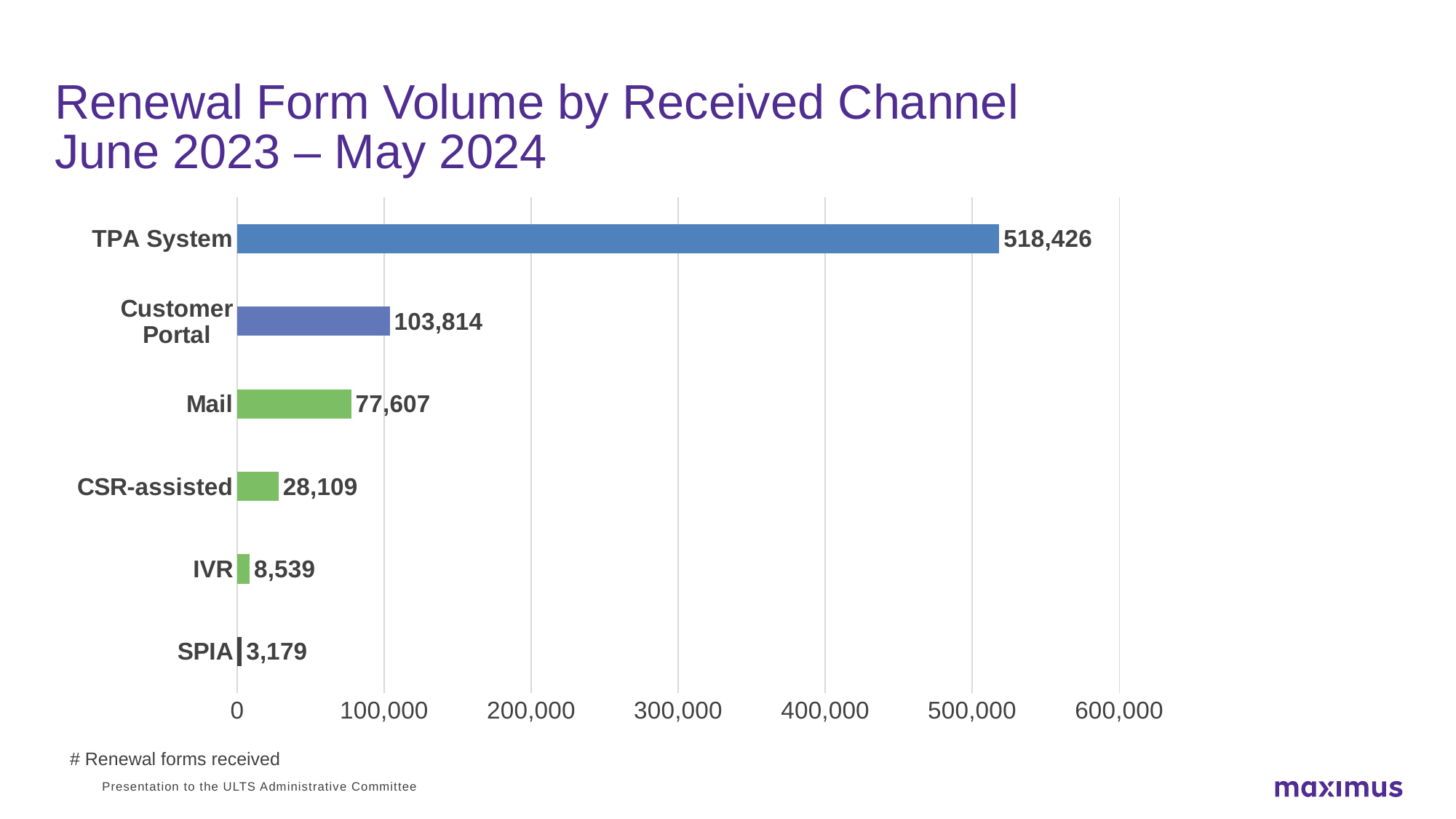
Which channel has the lowest renewal form volume? SPIA What is the difference between the Customer Portal and Mail values? 26,207 Is the value for Customer Portal greater or less than 100,000? greater What kind of chart is shown on the slide? bar chart How many channels are shown in the chart? 6 What is the value for Customer Portal? 103,814 What is the value for TPA System? 518,426 Which channel has the highest renewal form volume? TPA System What is the title of the chart on the slide? Renewal Form Volume by Received Channel June 2023 – May 2024 What is the value for IVR? 8,539 What is the value for Mail? 77,607 Which is larger, CSR-assisted or IVR? CSR-assisted